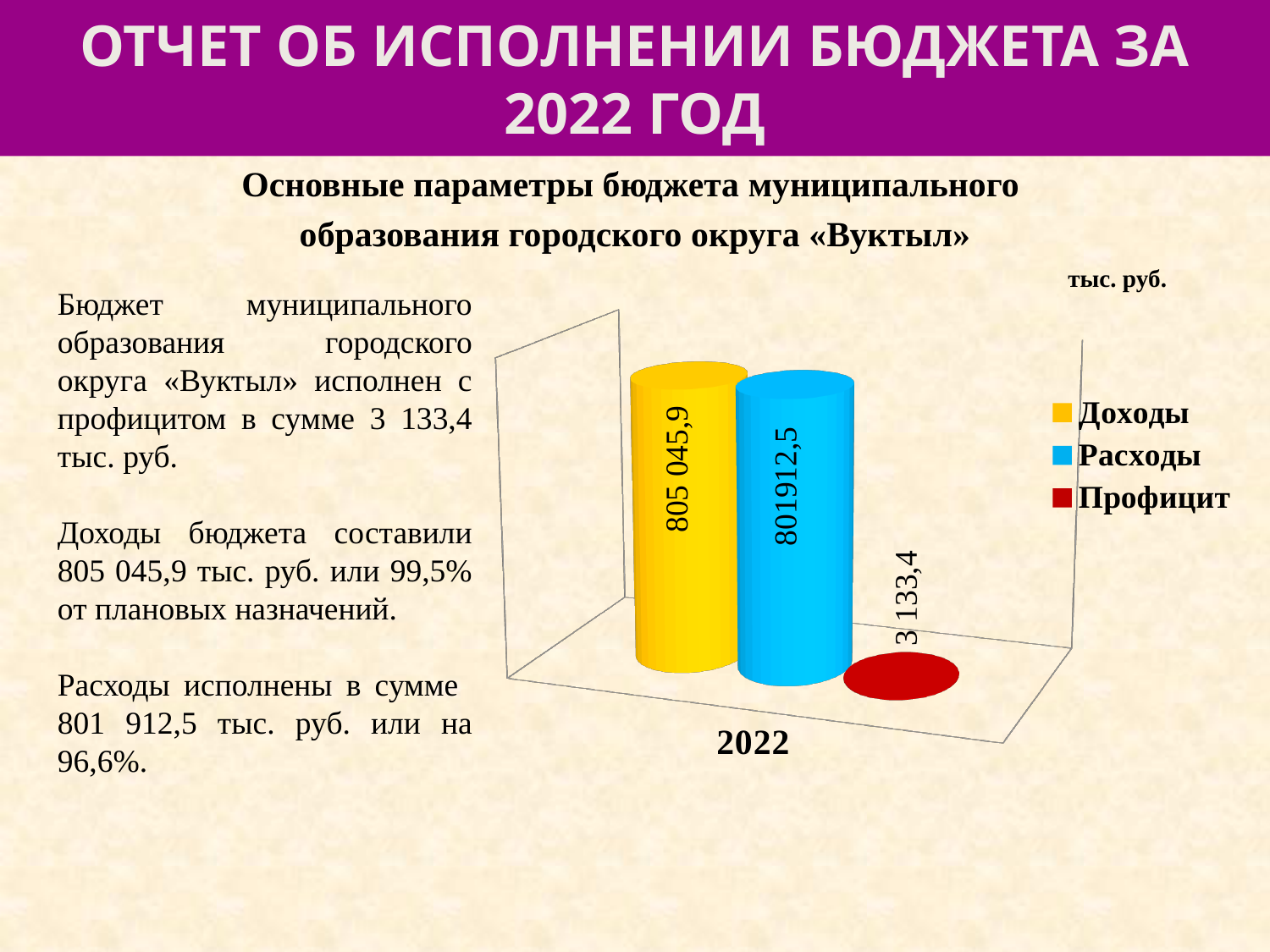
Which is larger in 2022, Расходы or Профицит? Расходы Which series has the lowest value in 2022? Профицит What is the value for Расходы in 2022? 801912,5 What is the value for Профицит in 2022? 3 133,4 How many categories are shown on the x axis? 1 Which series has the highest value in 2022? Доходы What unit is indicated above the chart? тыс. руб. What is the difference between Доходы and Расходы in 2022? 3 133,4 What kind of chart is shown on the slide? Bar chart How many series does the legend list? 3 What is the value for Доходы in 2022? 805 045,9 Which colour represents Расходы in the legend? Blue